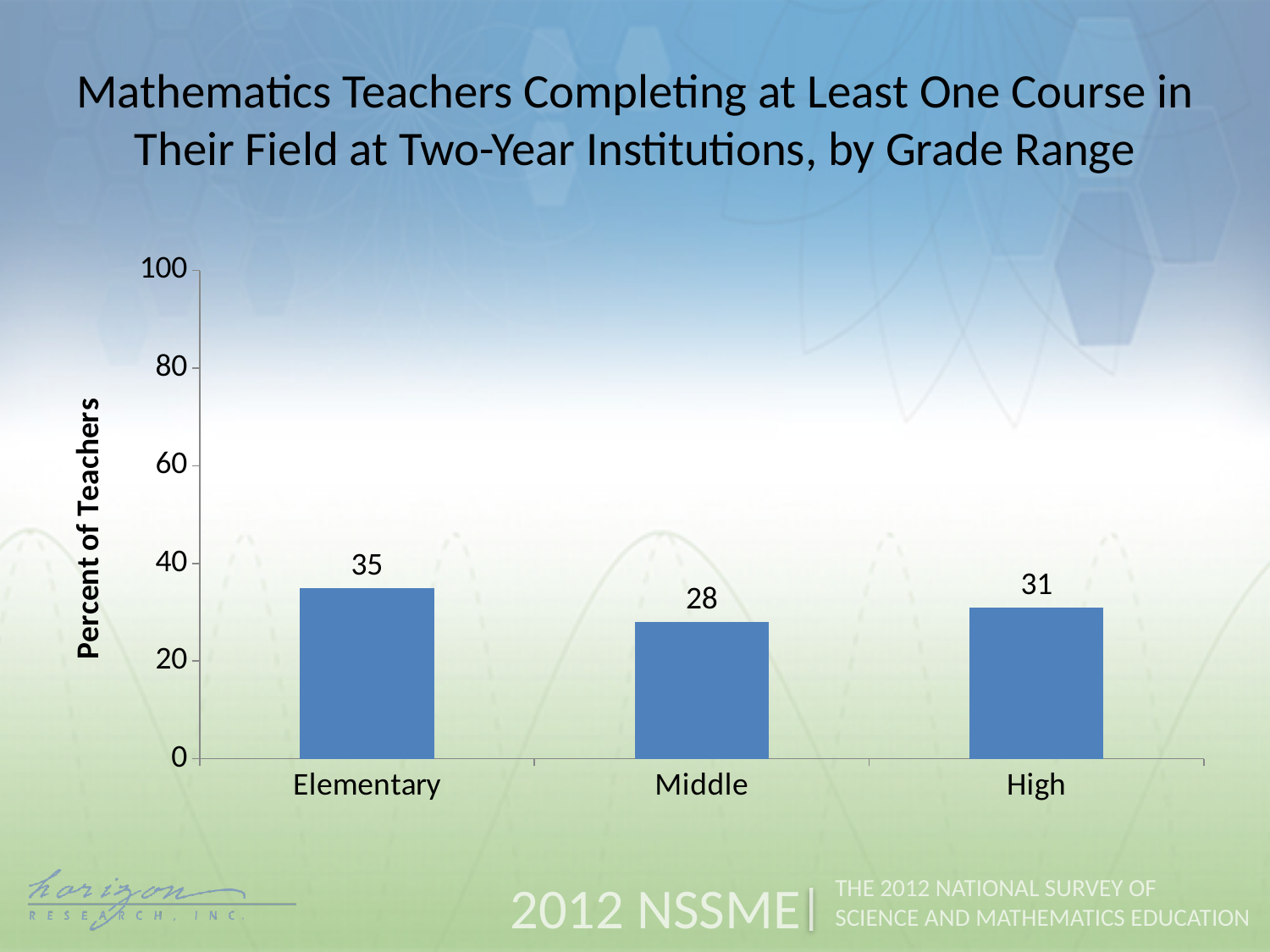
What is the value shown for High? 31 Which grade range has the highest percent of teachers? Elementary What is the difference between the values for Elementary and Middle? 7 What percent of elementary mathematics teachers completed at least one course in their field at two-year institutions? 35 Is the value for Middle greater or less than 40? less What is the difference between the values for High and Middle? 3 What is the label on the vertical axis? Percent of Teachers How many grade ranges are shown on the chart? 3 What kind of chart is shown on the slide? bar chart Which grade range has the lowest percent of teachers? Middle Which is larger, the value for Elementary or the value for High? Elementary What is the value shown for Middle? 28